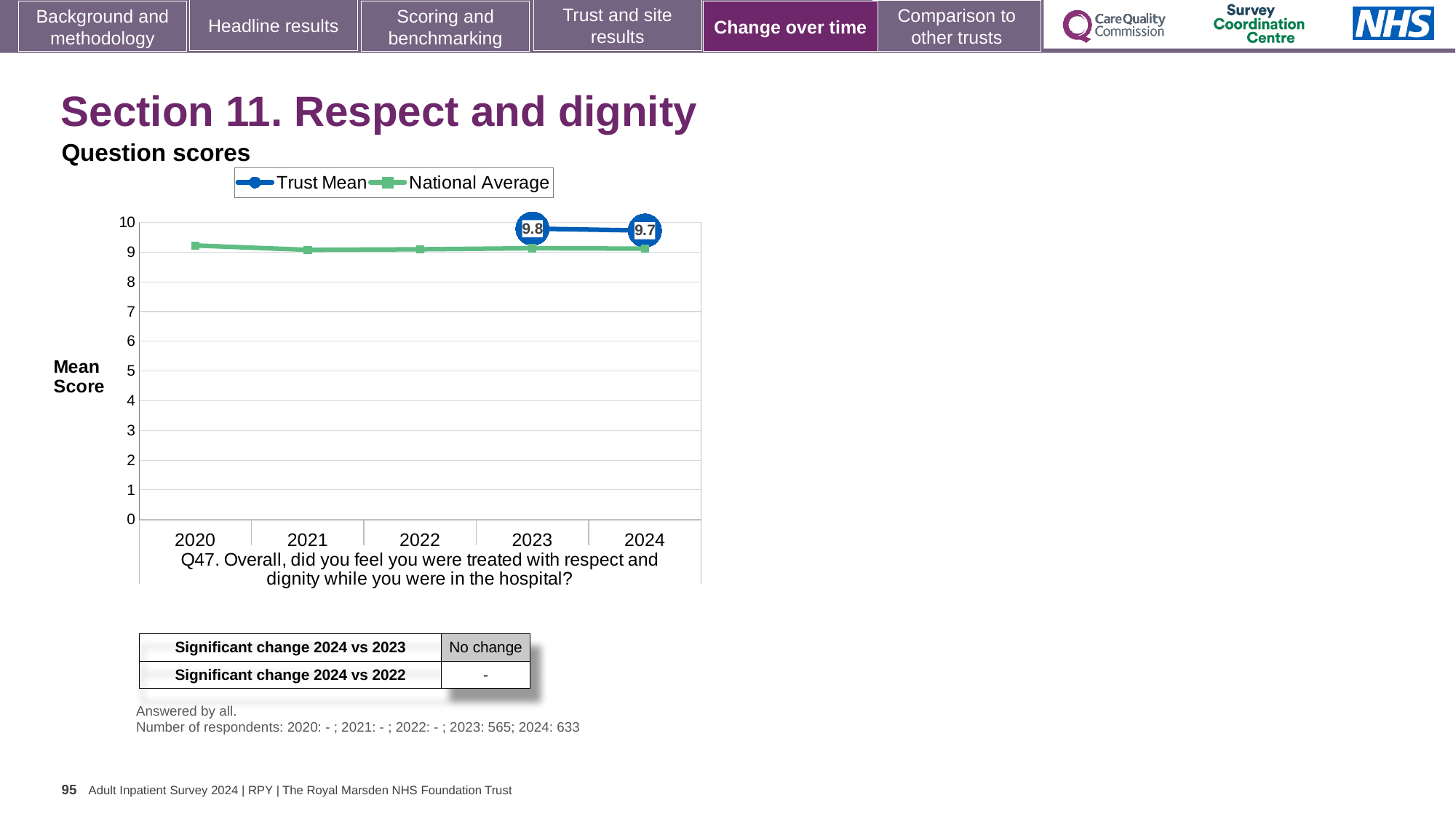
Is the National Average value for 2020 greater or less than 8? greater What is the Trust Mean score for 2024? 9.7 What is the difference between the Trust Mean scores for 2023 and 2024? 0.1 In 2024, which series has the higher value, Trust Mean or National Average? Trust Mean Which year has the higher Trust Mean score, 2023 or 2024? 2023 What is the Trust Mean score for 2023? 9.8 How many years are shown on the x axis of the chart? 5 What kind of chart is shown on the slide? Line chart Does the Trust Mean rise or fall from 2023 to 2024? Fall How many series does the chart legend list? 2 Is the National Average value for 2024 greater or less than 10? less What is the label on the y axis of the chart? Mean Score